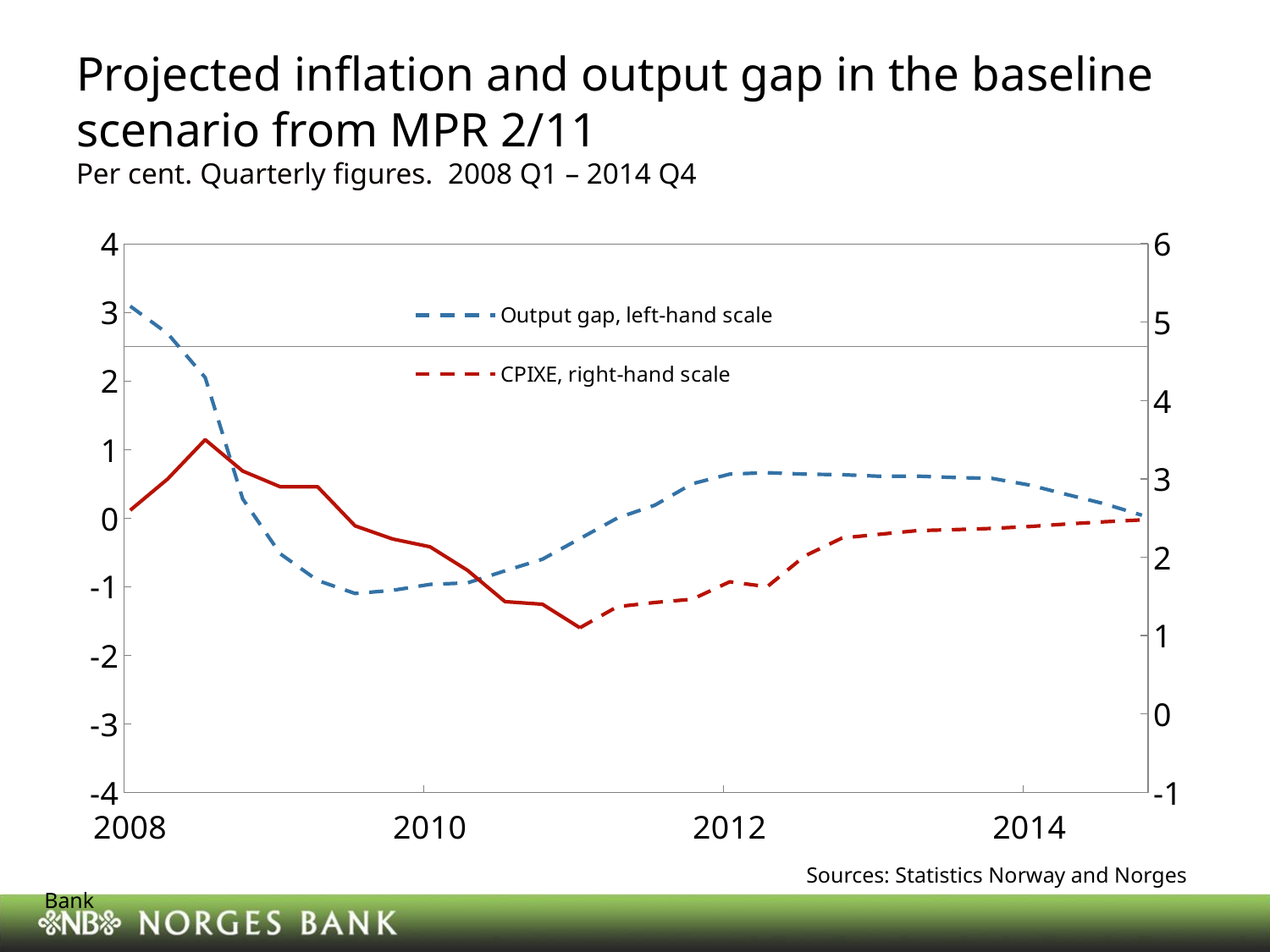
Is the output gap at the start of 2012 greater or less than 0 on the left-hand scale? greater Is the output gap at the start of 2010 greater or less than 0 on the left-hand scale? less Is the CPIXE value at the start of 2014 greater or less than 2 on the right-hand scale? greater How many series does the legend list? 2 Does the output gap rise or fall between 2008 and 2010? Fall Does CPIXE rise or fall between 2012 and 2014? Rise Which series is plotted against the right-hand scale? CPIXE Does the output gap rise or fall between 2010 and 2012? Rise What kind of chart is shown on the slide? Line chart What colour is the line for the output gap? Blue